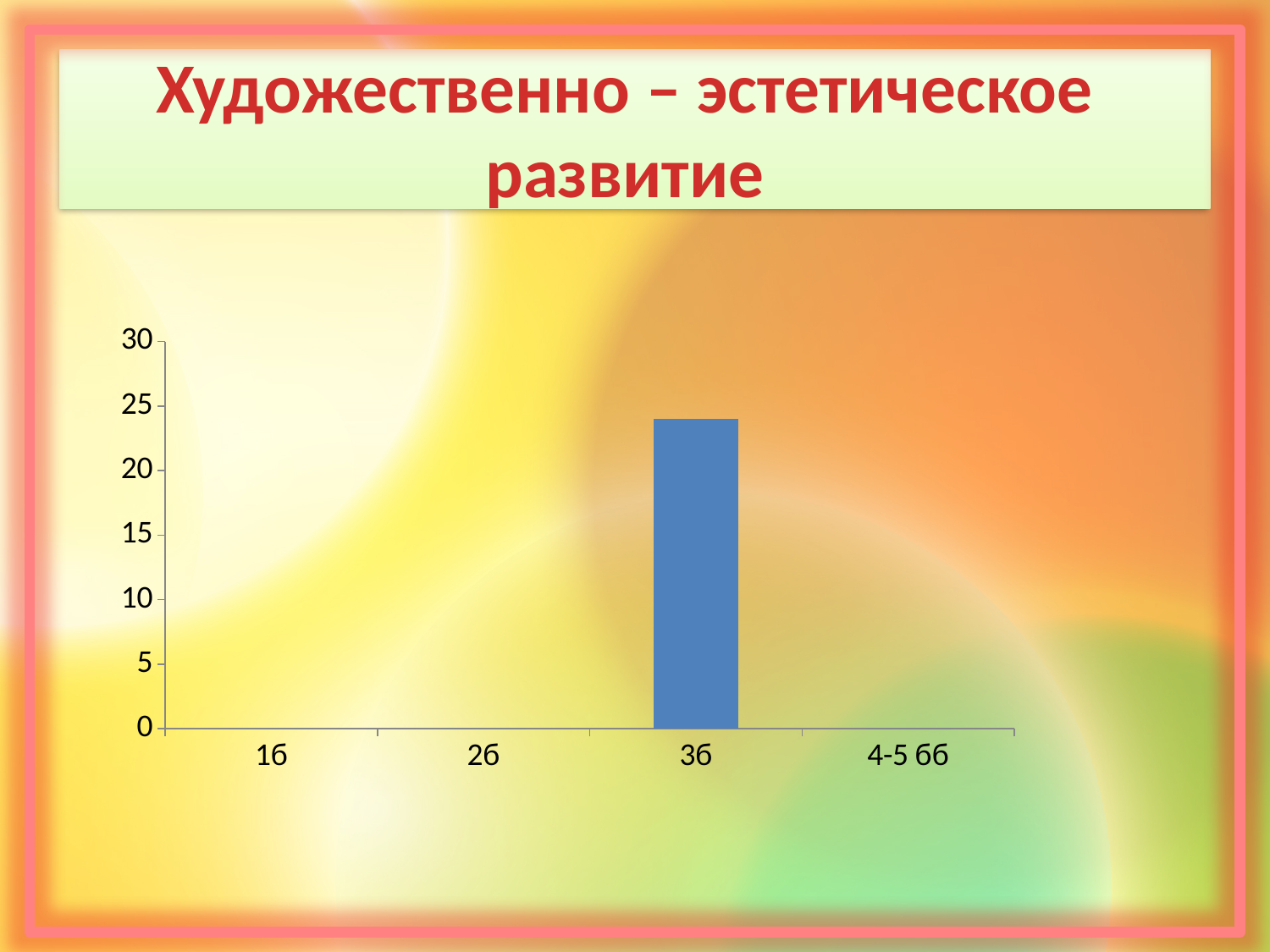
How many categories are shown on the x axis of the chart? 4 Which category has the highest bar in the chart? 3б Which is larger, the value for 3б or the value for 2б? 3б Which is larger, the value for 3б or the value for 4-5 бб? 3б What is the label of the last category on the x axis? 4-5 бб Is the value for 3б greater or less than 10? greater Is the value for 3б greater or less than 25? less What is the title of the slide containing the chart? Художественно – эстетическое развитие What kind of chart is shown on the slide? bar chart Is the value for 3б greater or less than 20? greater What is the highest value shown on the vertical axis of the chart? 30